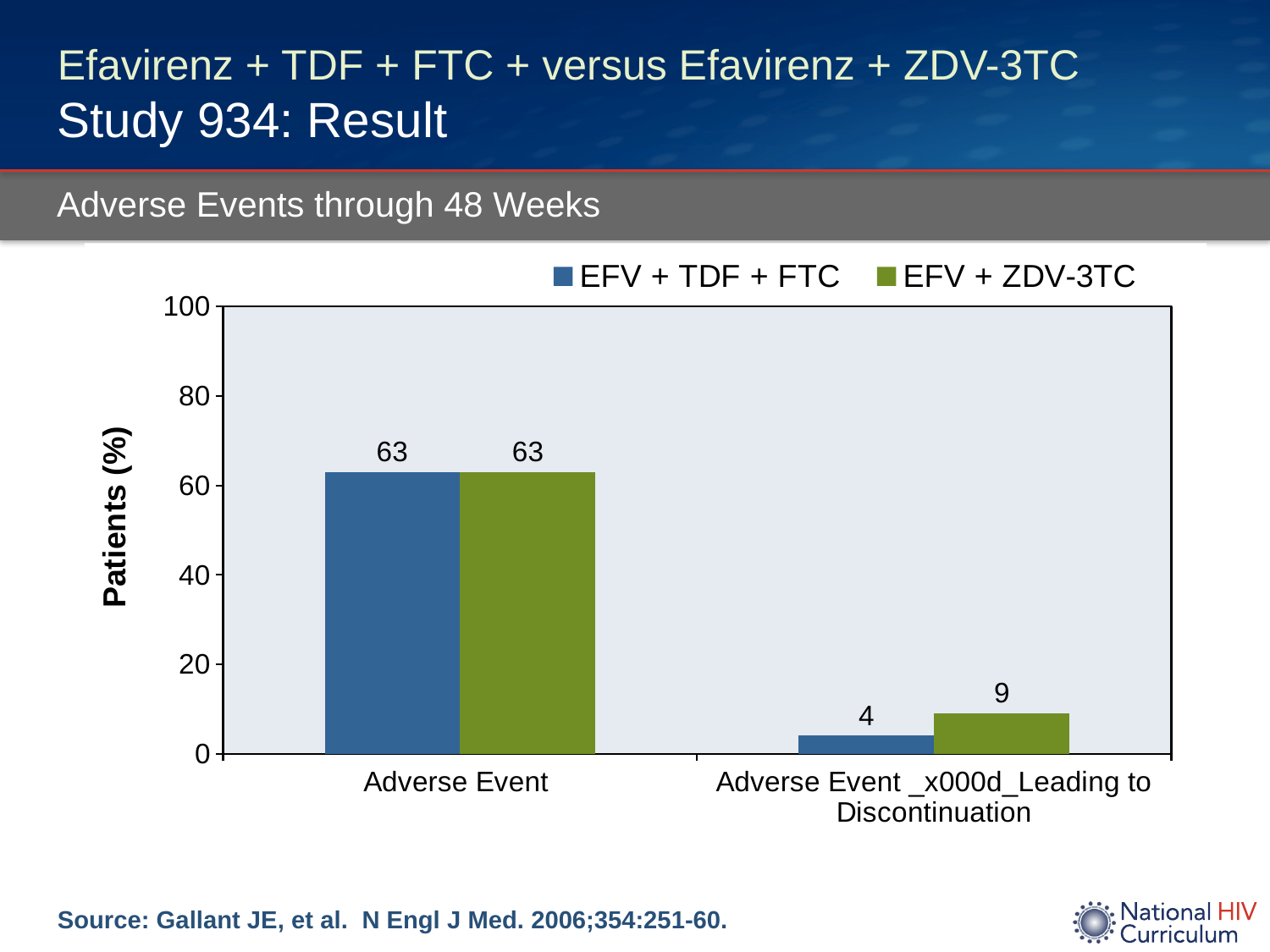
Which series has the larger value for Adverse Event Leading to Discontinuation, EFV + TDF + FTC or EFV + ZDV-3TC? EFV + ZDV-3TC What is the label of the y axis? Patients (%) Which category has the lowest value for the EFV + TDF + FTC series? Adverse Event Leading to Discontinuation What is the value for EFV + TDF + FTC in the Adverse Event Leading to Discontinuation category? 4 How many categories are shown on the x axis? 2 What is the difference between the EFV + ZDV-3TC and EFV + TDF + FTC values for Adverse Event Leading to Discontinuation? 5 What is the value for EFV + ZDV-3TC in the Adverse Event Leading to Discontinuation category? 9 Is the value for EFV + TDF + FTC in the Adverse Event category greater or less than 60? greater How many series does the legend list? 2 What is the value for EFV + TDF + FTC in the Adverse Event category? 63 What is the value for EFV + ZDV-3TC in the Adverse Event category? 63 What kind of chart is shown on the slide? Bar chart